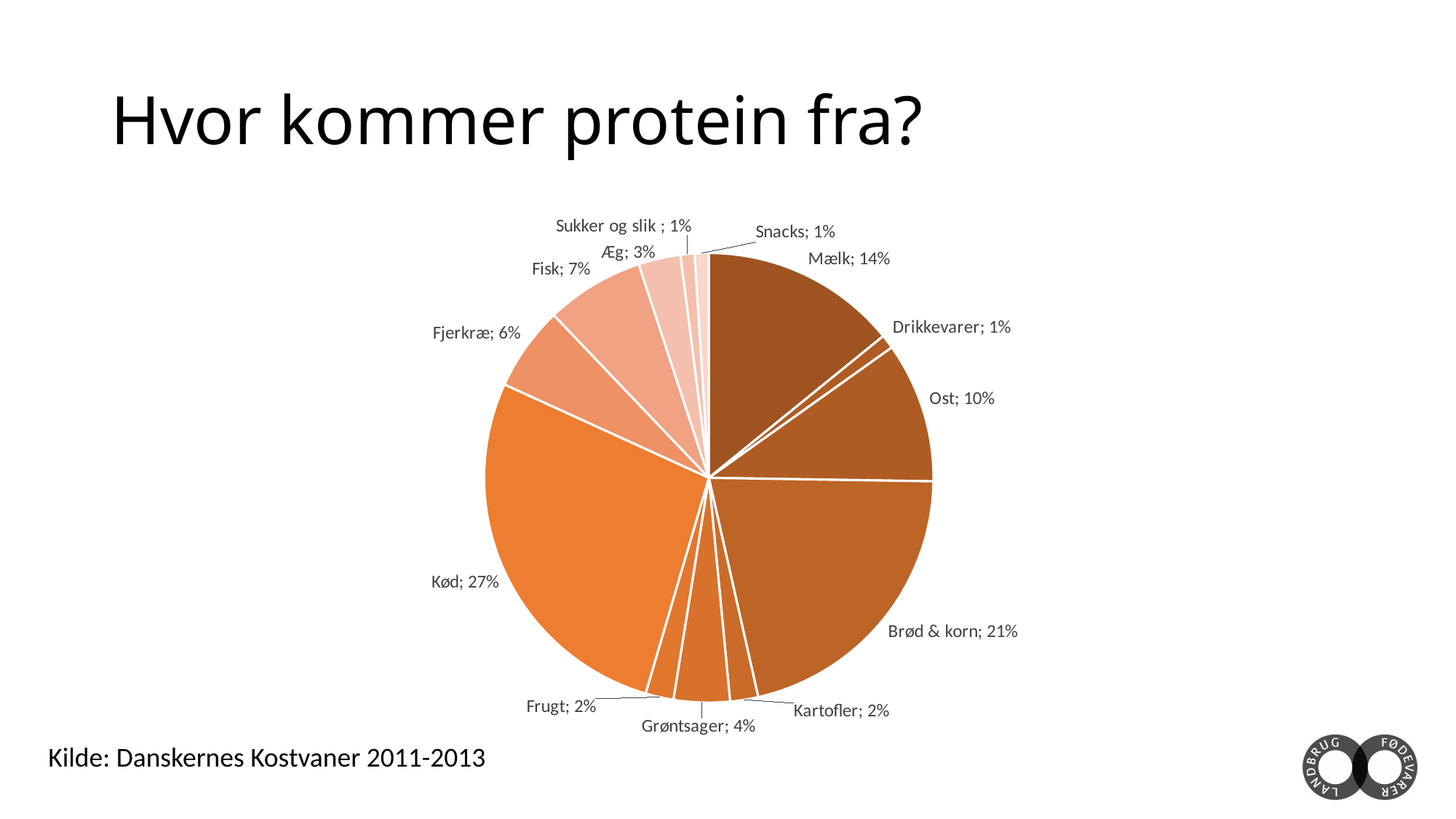
What share of protein comes from Fisk? 7% Which is larger, the share for Fjerkræ or the share for Fisk? Fisk How many categories are shown in the pie chart? 13 What is the difference between the shares for Kød and Brød & korn? 6% Which category has the largest share of the pie? Kød What is the title of the slide? Hvor kommer protein fra? What share of protein comes from Brød & korn? 21% What kind of chart is shown on the slide? pie chart What share of protein comes from Ost? 10% What share of protein comes from Kød? 27% What share of protein comes from Mælk? 14% What is the difference between the shares for Mælk and Ost? 4%